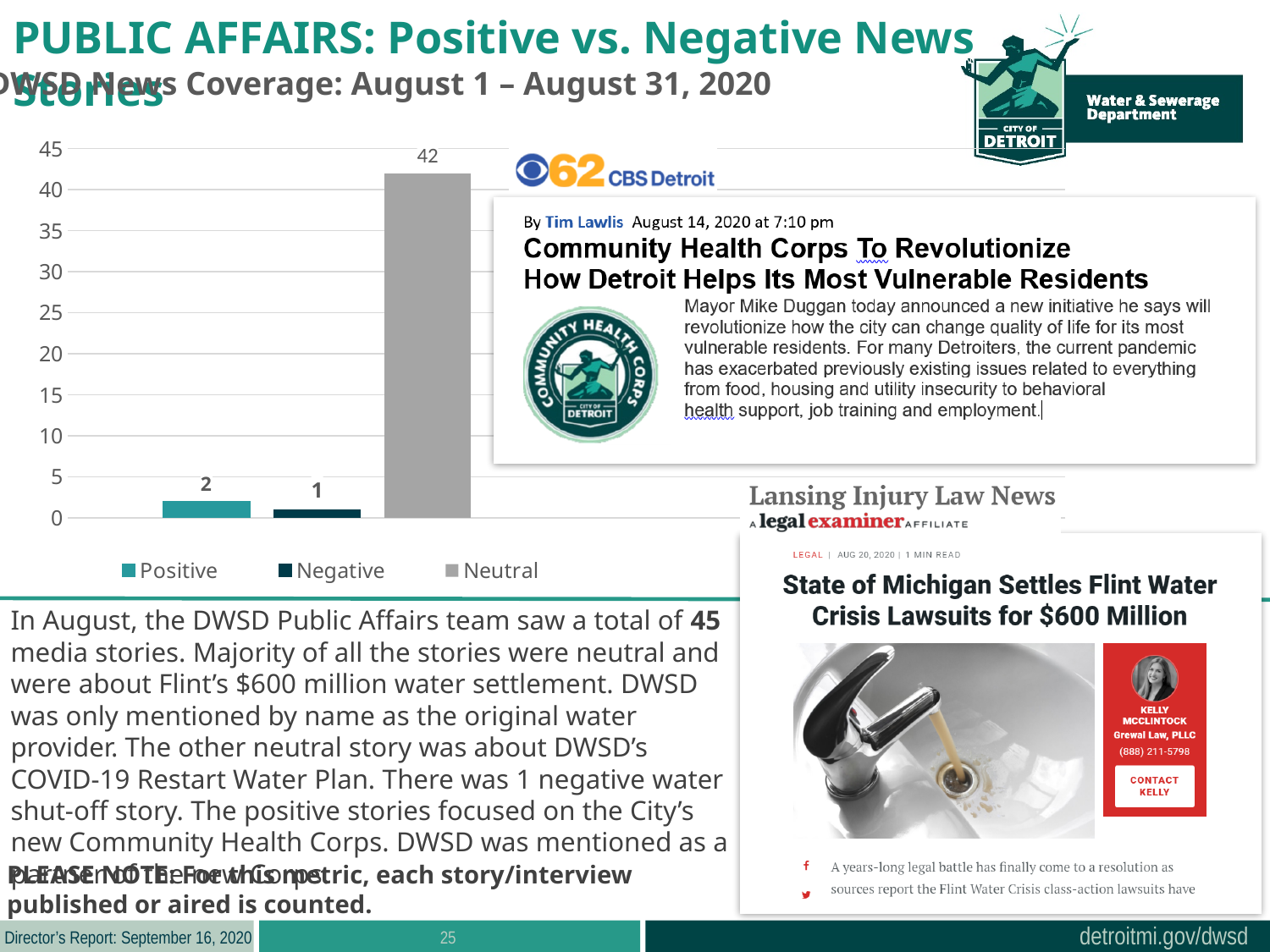
What kind of chart is shown on the slide? Bar chart What is the value for Positive stories in the chart? 2 What is the highest value shown on the chart's vertical axis? 45 What is the difference between the Positive and Negative values? 1 How many series does the legend list? 3 What is the value for Negative stories in the chart? 1 What is the value for Neutral stories in the chart? 42 Is the value for Neutral greater or less than 40? greater Which category has the highest value in the chart? Neutral What is the difference between the Neutral and Positive values? 40 Which is larger, the Positive value or the Negative value? Positive Which category has the lowest value in the chart? Negative